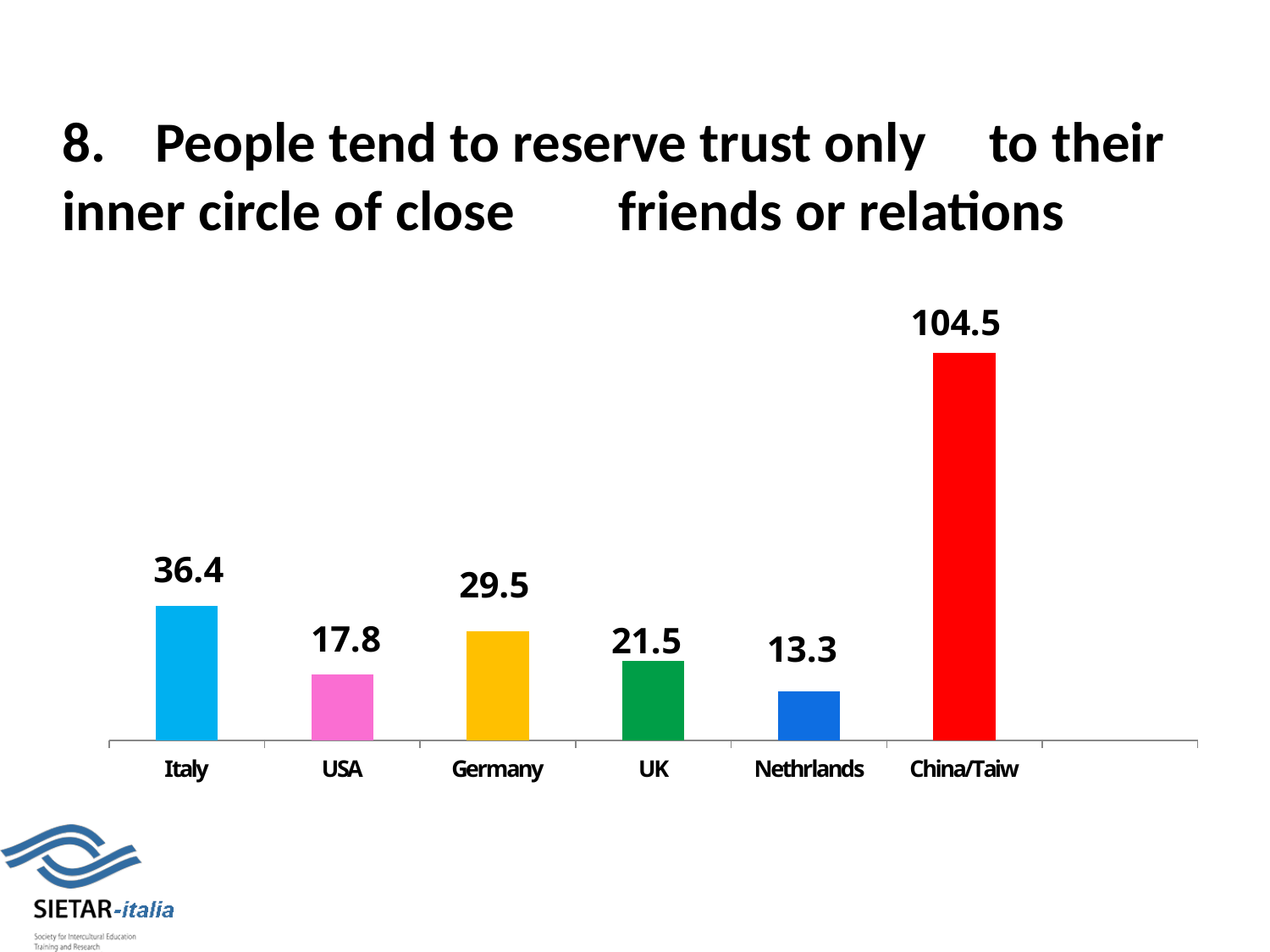
What is the value for Germany? 29.5 What colour is the bar for China/Taiw? red What is the value for China/Taiw? 104.5 Which category has the lowest value? Nethrlands What is the difference between the values for Italy and USA? 18.6 What kind of chart is shown on the slide? bar chart How many categories are shown on the x axis? 6 What is the difference between the values for China/Taiw and Germany? 75 Which category has the highest value? China/Taiw What is the value for Nethrlands? 13.3 What is the value for Italy? 36.4 Which is larger, the value for UK or the value for USA? UK